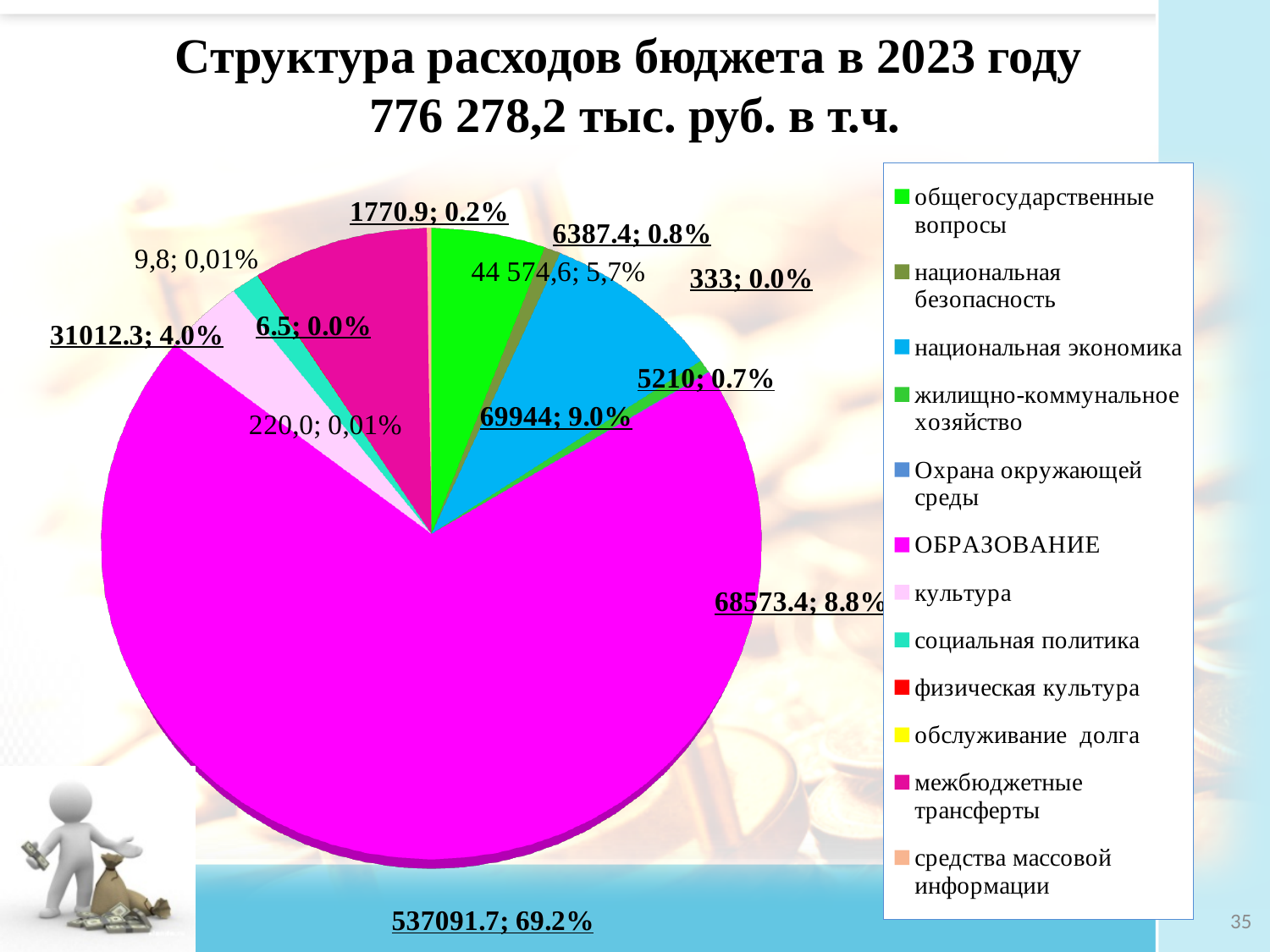
What data label is shown for the ОБРАЗОВАНИЕ slice? 537091.7; 69.2% What data label is shown for the национальная экономика slice? 69944; 9.0% What share of the pie does the ОБРАЗОВАНИЕ slice represent? 69.2% What kind of chart is shown on the slide? pie chart Which slice is larger, ОБРАЗОВАНИЕ or культура? ОБРАЗОВАНИЕ How many categories does the legend of the pie chart list? 12 What total budget expenditure amount is given in the chart title? 776 278,2 тыс. руб. Which category has the largest slice of the pie chart? ОБРАЗОВАНИЕ What colour is the ОБРАЗОВАНИЕ slice in the pie chart? magenta Which slice is larger, национальная экономика or общегосударственные вопросы? национальная экономика What share of the pie does the культура slice represent? 4.0% What share of the pie does the общегосударственные вопросы slice represent? 5,7%